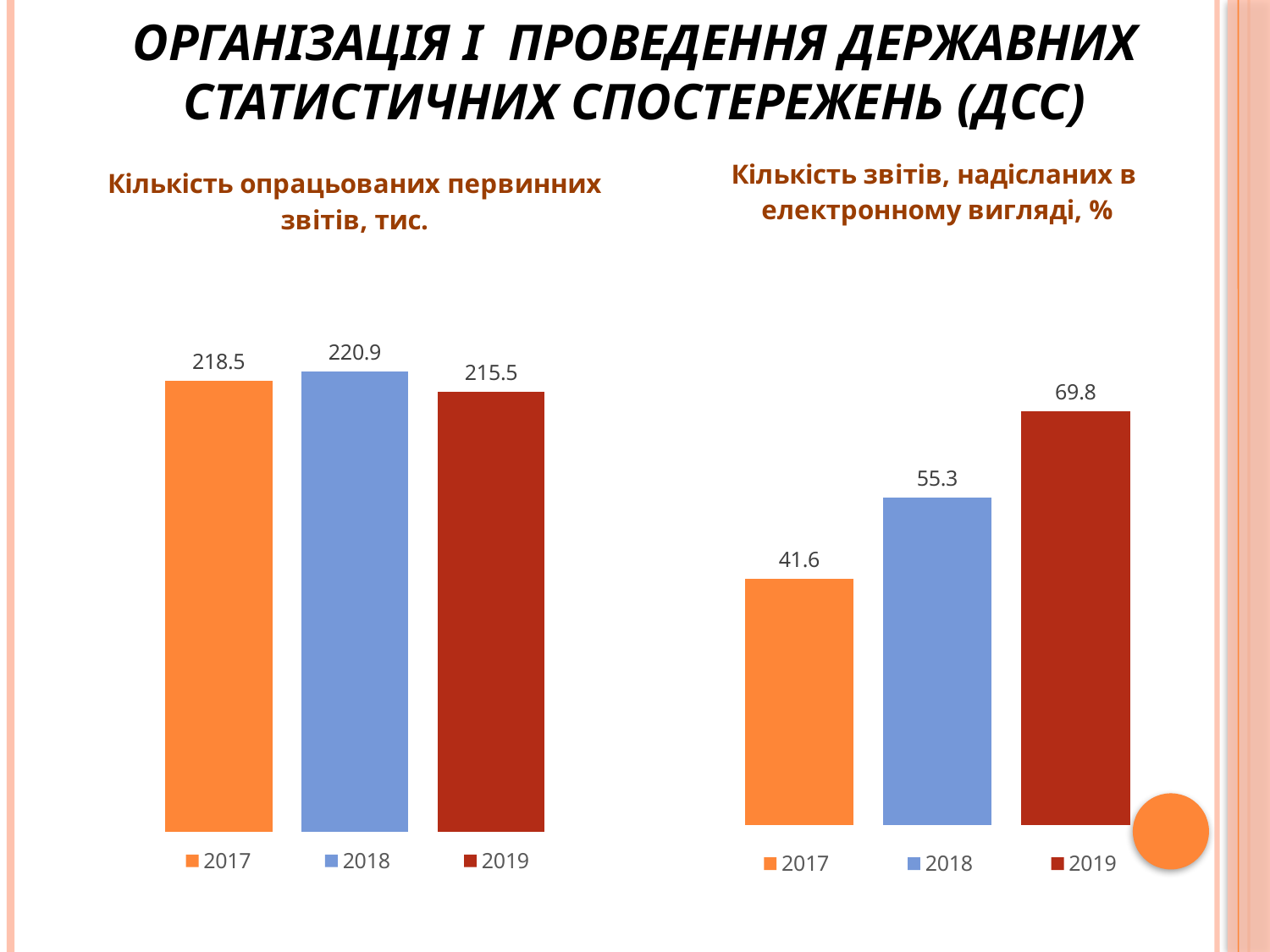
How many series does the legend of the right chart (Кількість звітів, надісланих в електронному вигляді, %) list? 3 In the right chart (Кількість звітів, надісланих в електронному вигляді, %), what is the value for 2017? 41.6 In the left chart (Кількість опрацьованих первинних звітів, тис.), what is the difference between the 2018 and 2019 values? 5.4 In the left chart (Кількість опрацьованих первинних звітів, тис.), what is the value for 2019? 215.5 In the right chart (Кількість звітів, надісланих в електронному вигляді, %), which year has the lowest value? 2017 In the left chart (Кількість опрацьованих первинних звітів, тис.), which year has the highest value? 2018 What kind of chart is the left chart (Кількість опрацьованих первинних звітів, тис.)? bar chart In the right chart (Кількість звітів, надісланих в електронному вигляді, %), what is the value for 2019? 69.8 In the left chart (Кількість опрацьованих первинних звітів, тис.), what is the value for 2018? 220.9 In the right chart (Кількість звітів, надісланих в електронному вигляді, %), do the values rise or fall from 2017 to 2019? rise In the left chart (Кількість опрацьованих первинних звітів, тис.), which year has the lowest value? 2019 In the right chart (Кількість звітів, надісланих в електронному вигляді, %), what is the difference between the 2019 and 2017 values? 28.2